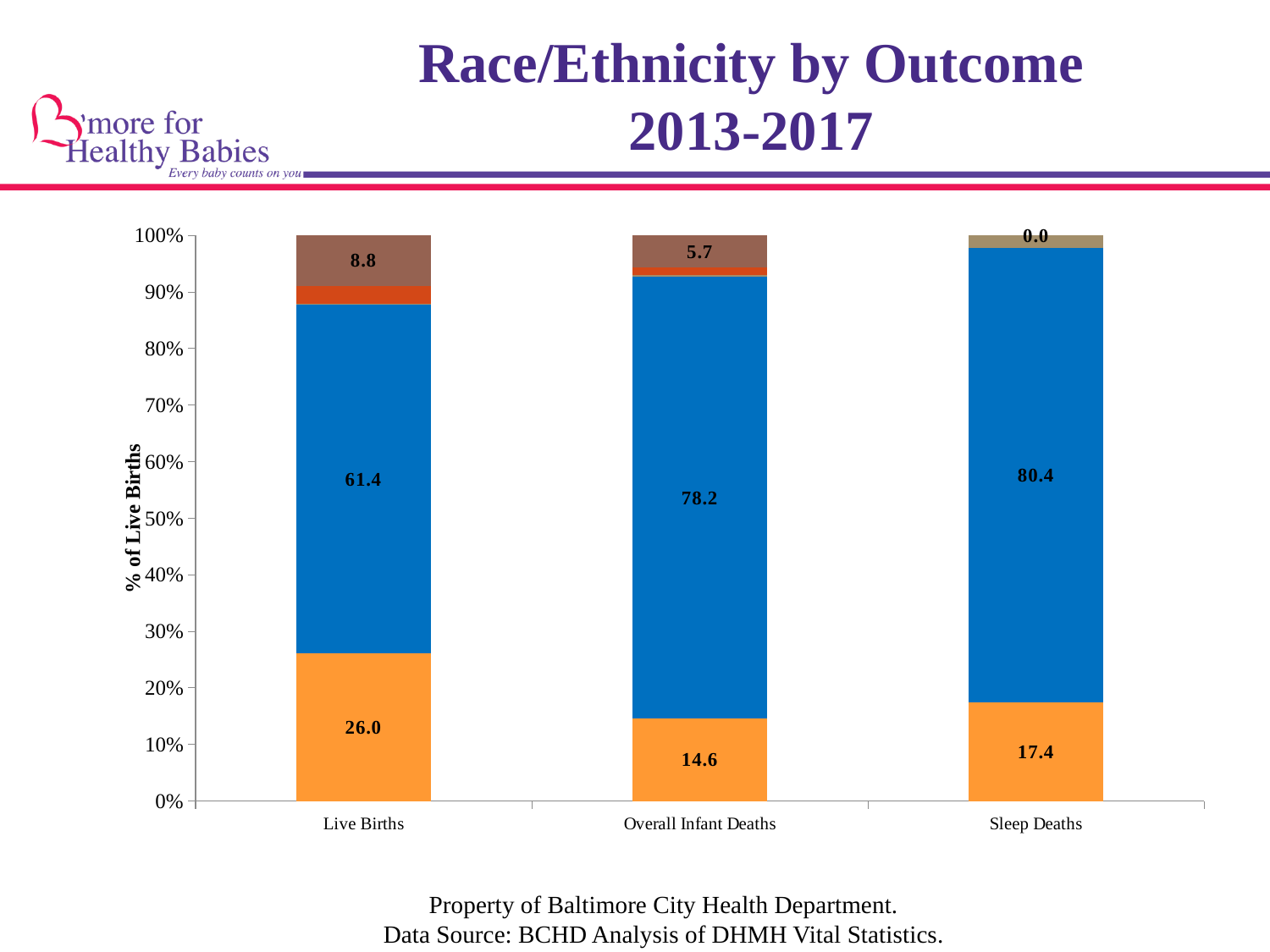
What is the value of the top segment for Live Births? 8.8 Which category has the highest value for the blue segment? Sleep Deaths What is the value of the blue segment for Overall Infant Deaths? 78.2 What is the difference between the blue segment values for Sleep Deaths and Live Births? 19.0 How many categories are shown on the x axis of the chart? 3 Is the orange (bottom) segment value larger for Live Births or for Overall Infant Deaths? Live Births What is the label of the y axis of the chart? % of Live Births What is the value of the orange (bottom) segment for Live Births? 26.0 What kind of chart is shown on the slide? stacked bar chart What is the value of the blue segment for Sleep Deaths? 80.4 Which category has the lowest value for the orange (bottom) segment? Overall Infant Deaths What is the value of the orange (bottom) segment for Sleep Deaths? 17.4